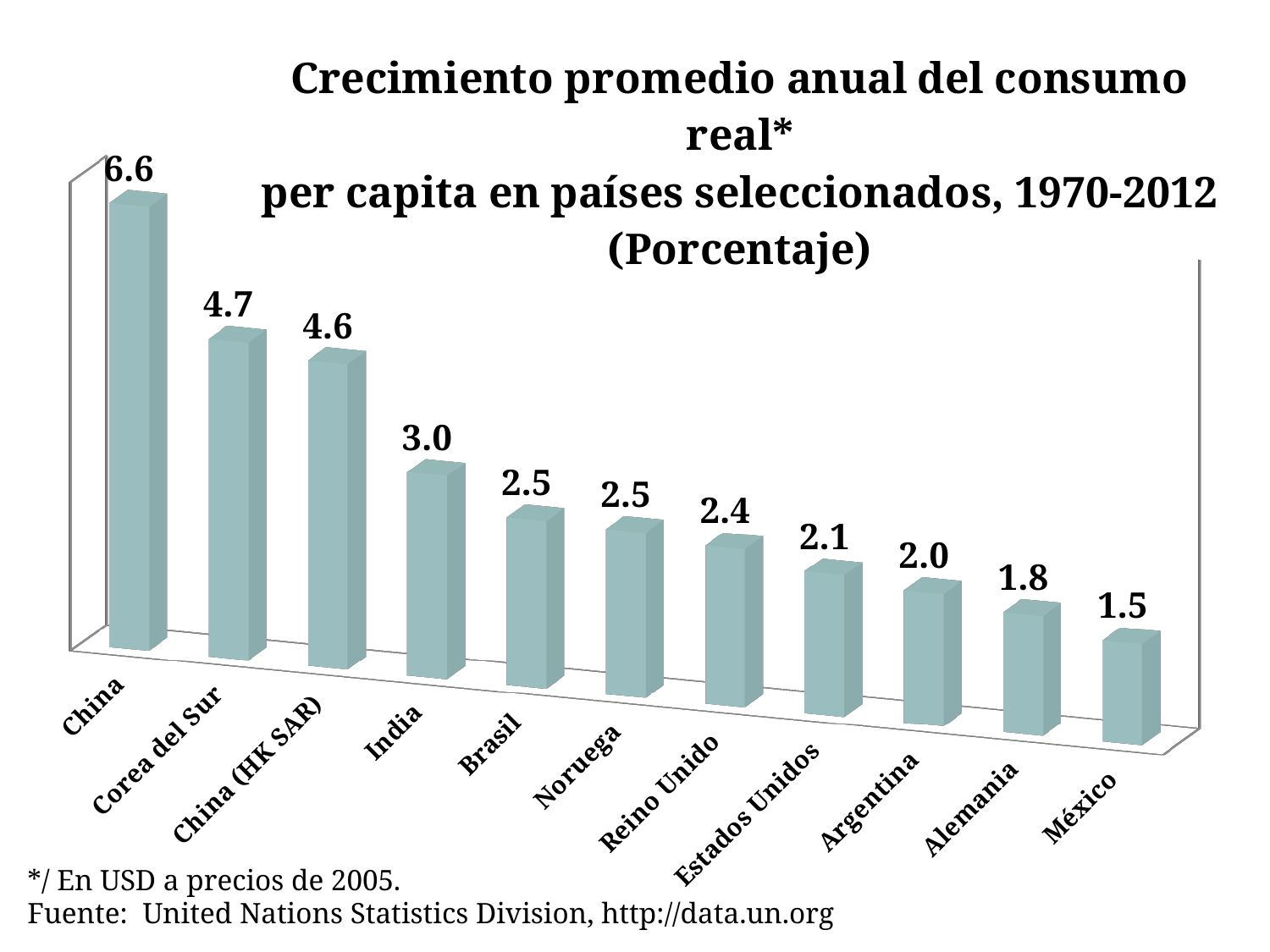
How many countries are shown in the chart? 11 Which country has the lowest value? México What kind of chart is this? bar chart Which is larger, the value for Corea del Sur or the value for India? Corea del Sur What is the difference between the values for Alemania and México? 0.3 Which country has the highest value? China What is the value for India? 3.0 What is the difference between the values for China and Corea del Sur? 1.9 Do the values rise or fall from left to right along the x axis? fall What is the source cited for the chart? United Nations Statistics Division, http://data.un.org What is the value for China? 6.6 What is the value for Estados Unidos? 2.1